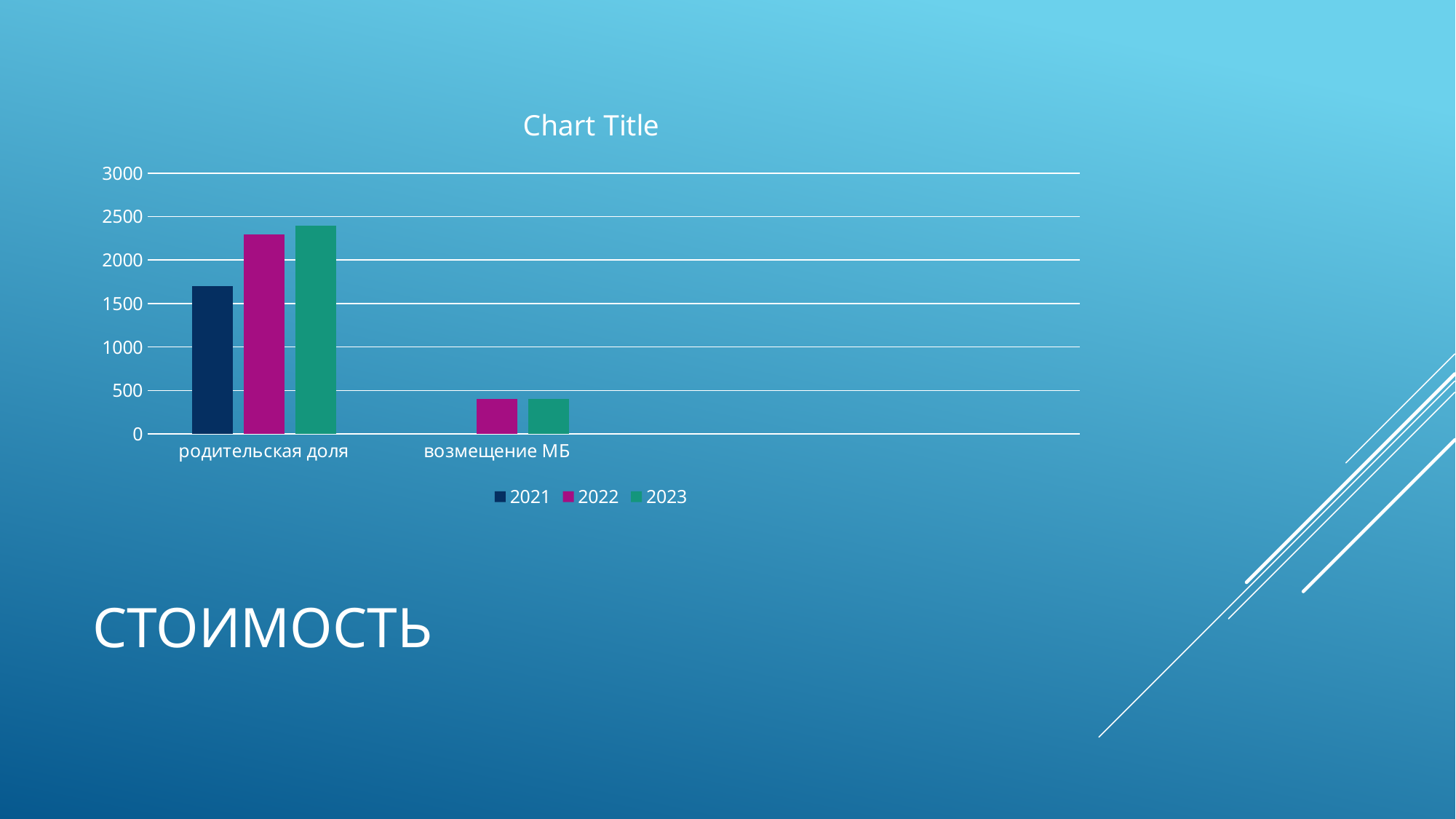
For родительская доля, which is larger: the 2021 value or the 2022 value? 2022 How many categories are shown on the x axis of the chart? 2 Is the 2022 value for родительская доля greater or less than 2000? greater What kind of chart is shown on the slide? bar chart How many series does the chart legend list? 3 Is the 2021 value for родительская доля greater or less than 2000? less Is the 2022 value for возмещение МБ greater or less than 500? less Which series are listed in the chart legend? 2021, 2022, 2023 Which category has the higher 2023 value? родительская доля What is the title of the chart? Chart Title